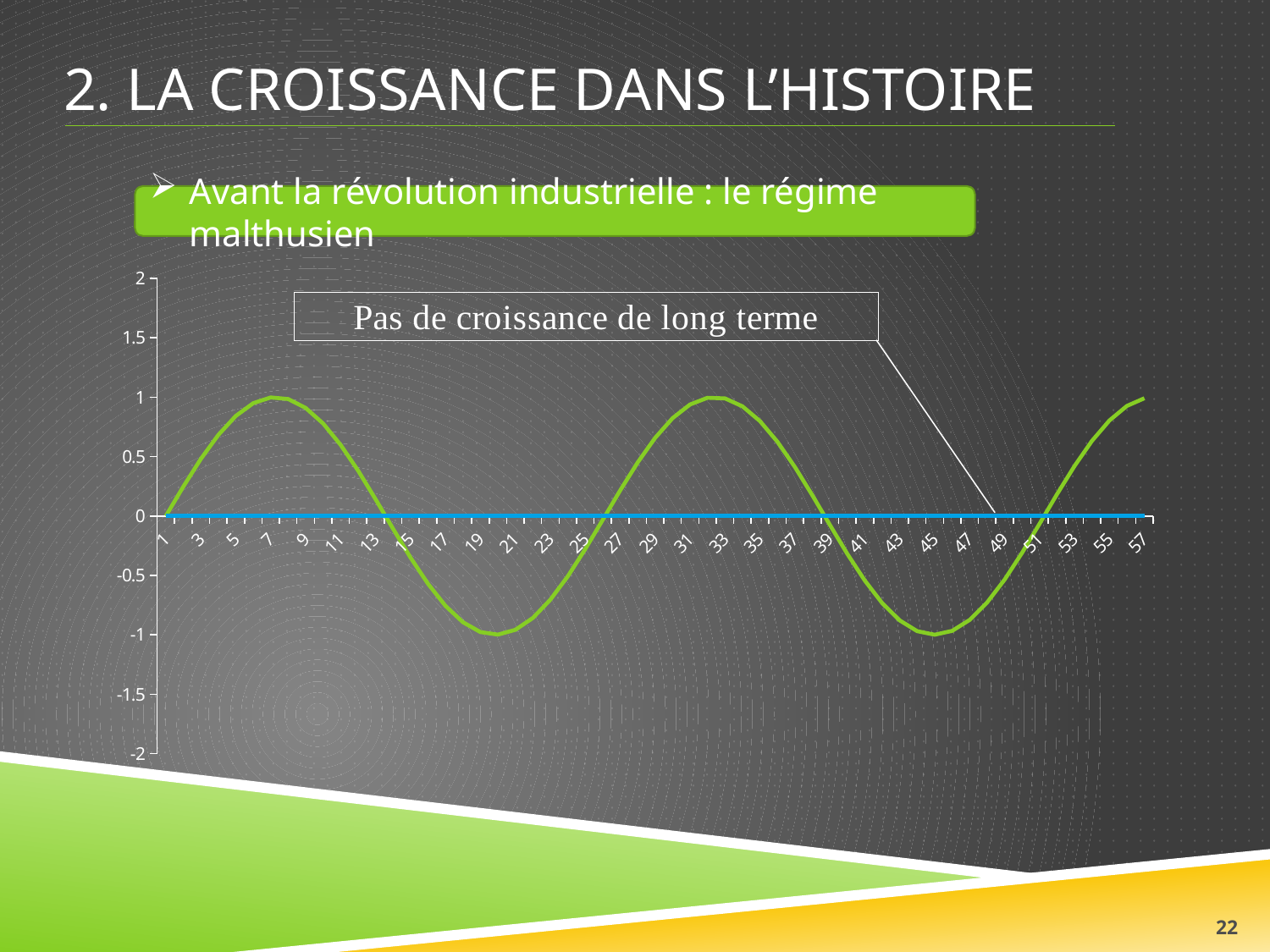
Is the value of the green line at x = 45 greater or less than -0.5? less What is the minimum value reached by the green line? -1 What text is written in the annotation box above the chart? Pas de croissance de long terme What is the highest value shown on the y axis? 2 What is the lowest value shown on the y axis? -2 Does the blue line rise, fall, or stay flat along the x axis? stays flat What is the last label on the x axis? 57 What is the first label on the x axis? 1 Is the value of the green line at x = 7 greater or less than 0.5? greater Is the value of the green line at x = 19 greater or less than -0.5? less What is the maximum value reached by the green line? 1 What type of chart is shown on the slide? line chart